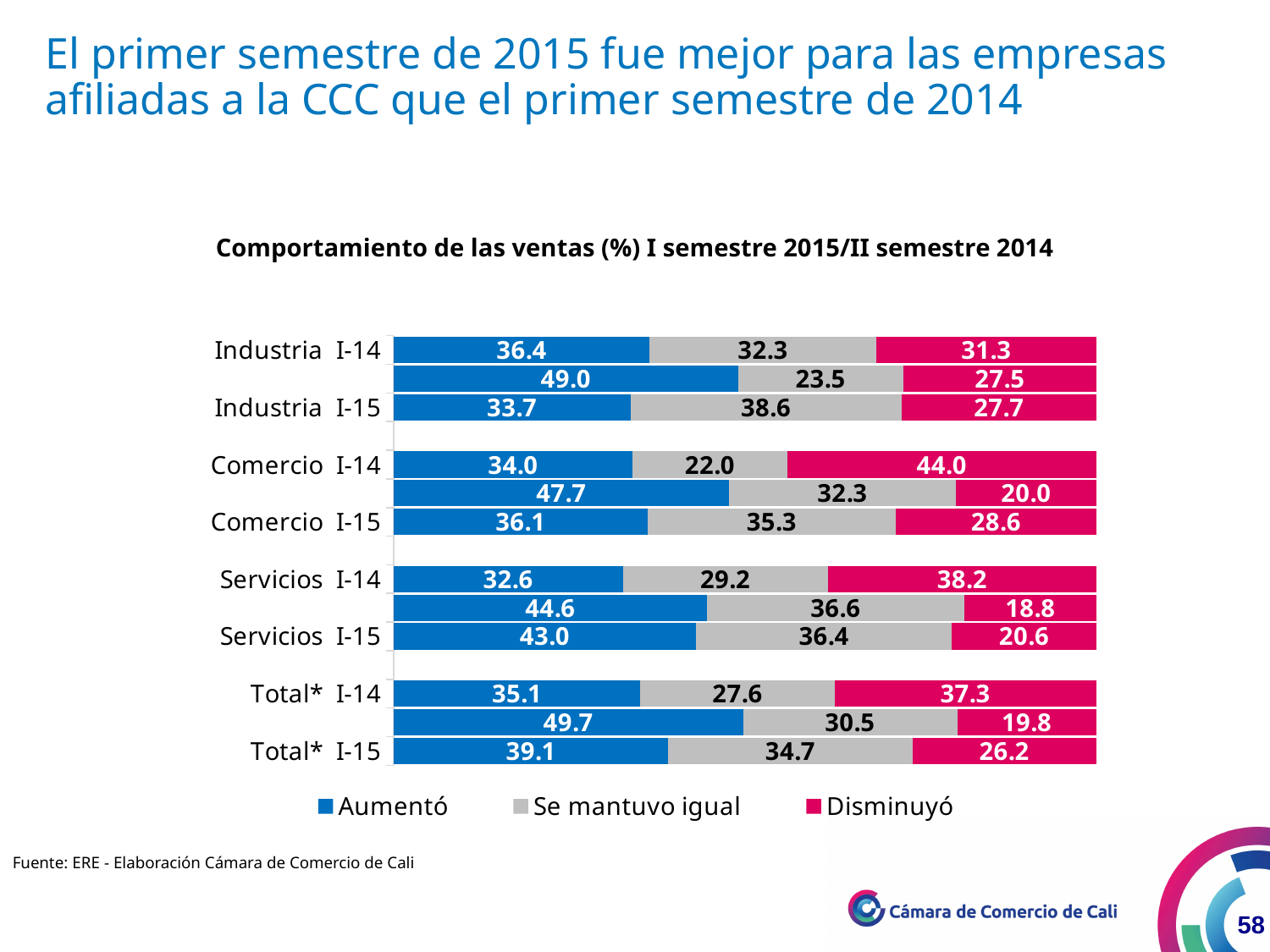
What is the 'Disminuyó' value for Industria I-15? 27.7 How many series does the legend list? 3 Which colour represents 'Disminuyó' in the chart? Pink What is the 'Aumentó' value for Total* I-15? 39.1 Which is larger: the 'Disminuyó' value for Total* I-14 or for Total* I-15? Total* I-14 Which labeled category has the lowest 'Aumentó' value? Servicios I-14 What kind of chart is shown on the slide? Stacked bar chart What is the 'Se mantuvo igual' value for Servicios I-15? 36.4 What percentage of Industria firms reported that sales 'Aumentó' in I-14? 36.4 Which labeled category has the highest 'Disminuyó' value? Comercio I-14 What is the 'Disminuyó' value for Comercio I-14? 44.0 What is the difference between the 'Aumentó' values for Servicios I-15 and Servicios I-14? 10.4